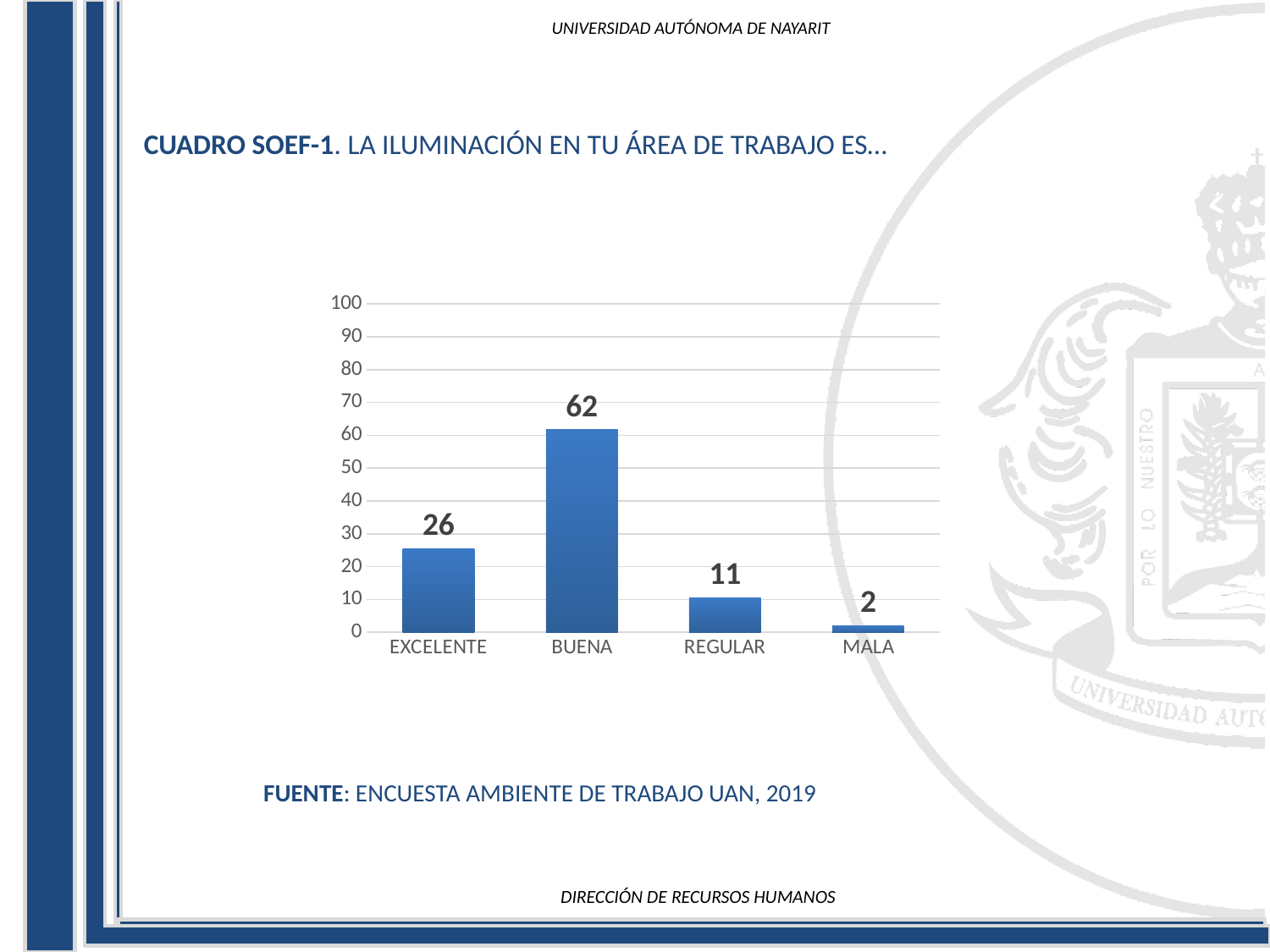
What is the difference between the values for BUENA and EXCELENTE? 36 What kind of chart is shown on the slide? bar chart What is the value for BUENA? 62 Which category has the highest value? BUENA Which category has the lowest value? MALA What is the value for MALA? 2 What is the value for EXCELENTE? 26 How many categories are shown on the x axis? 4 Which is larger, the value for EXCELENTE or the value for REGULAR? EXCELENTE What is the value for REGULAR? 11 What is the highest value shown on the y axis? 100 What is the difference between the values for REGULAR and MALA? 9